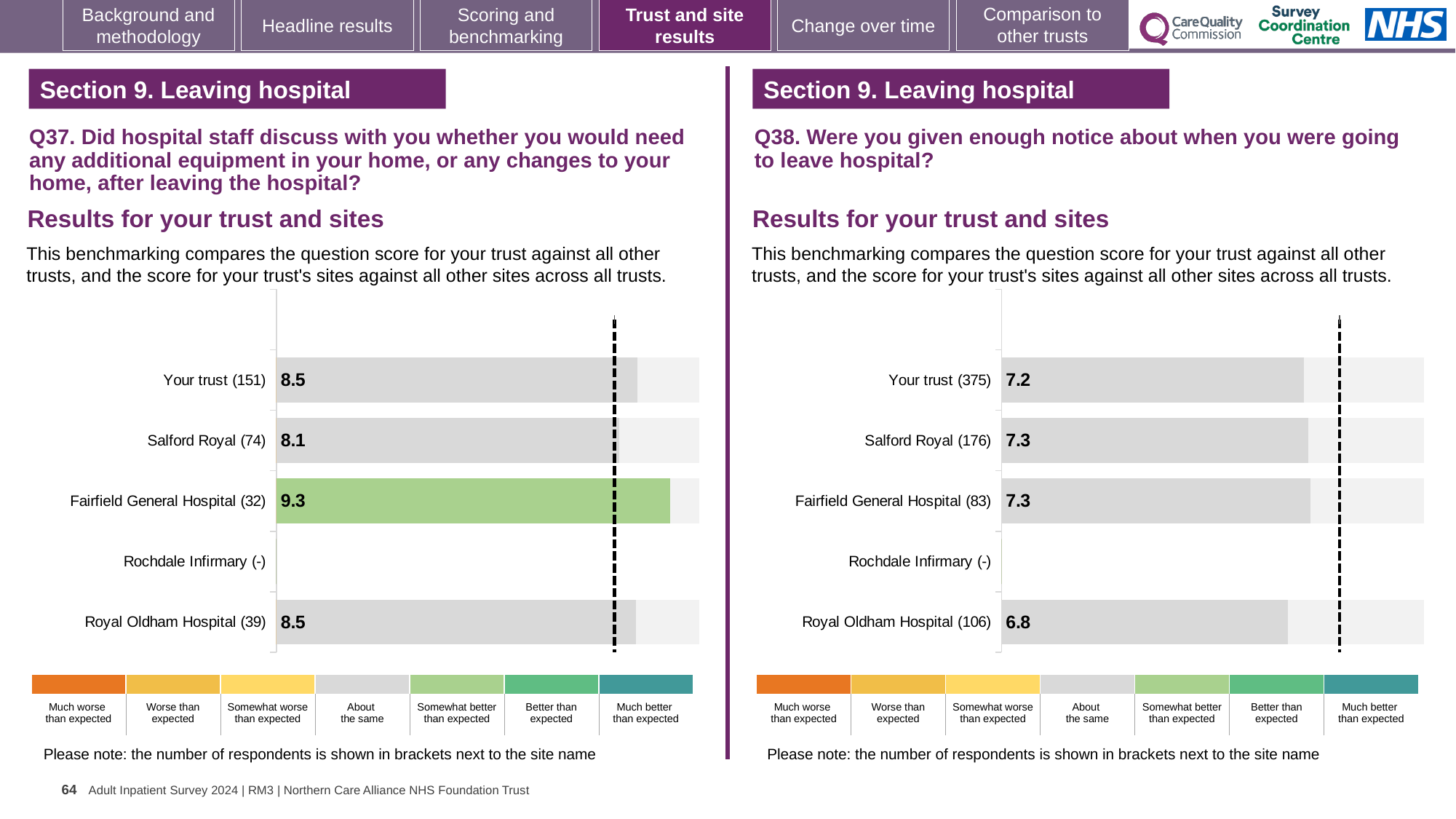
In the Q38 chart on the right, which is larger, the score for Salford Royal or the score for Royal Oldham Hospital? Salford Royal What kind of chart is used for the Q37 results on the left? Bar chart In the Q37 chart on the left, what is the score for Your trust? 8.5 In the Q38 chart on the right, which site has the lowest score? Royal Oldham Hospital In the Q37 chart on the left, what is the score for Salford Royal? 8.1 In the Q37 chart on the left, which site has the highest score? Fairfield General Hospital In the Q38 chart on the right, what is the score for Royal Oldham Hospital? 6.8 In the Q37 chart on the left, how many respondents are shown for Fairfield General Hospital? 32 In the Q38 chart on the right, what is the score for Your trust? 7.2 In the Q38 chart on the right, how many respondents are shown for Your trust? 375 In the Q37 chart on the left, what is the difference between the scores for Fairfield General Hospital and Salford Royal? 1.2 In the Q37 chart on the left, which site has the lowest score? Salford Royal